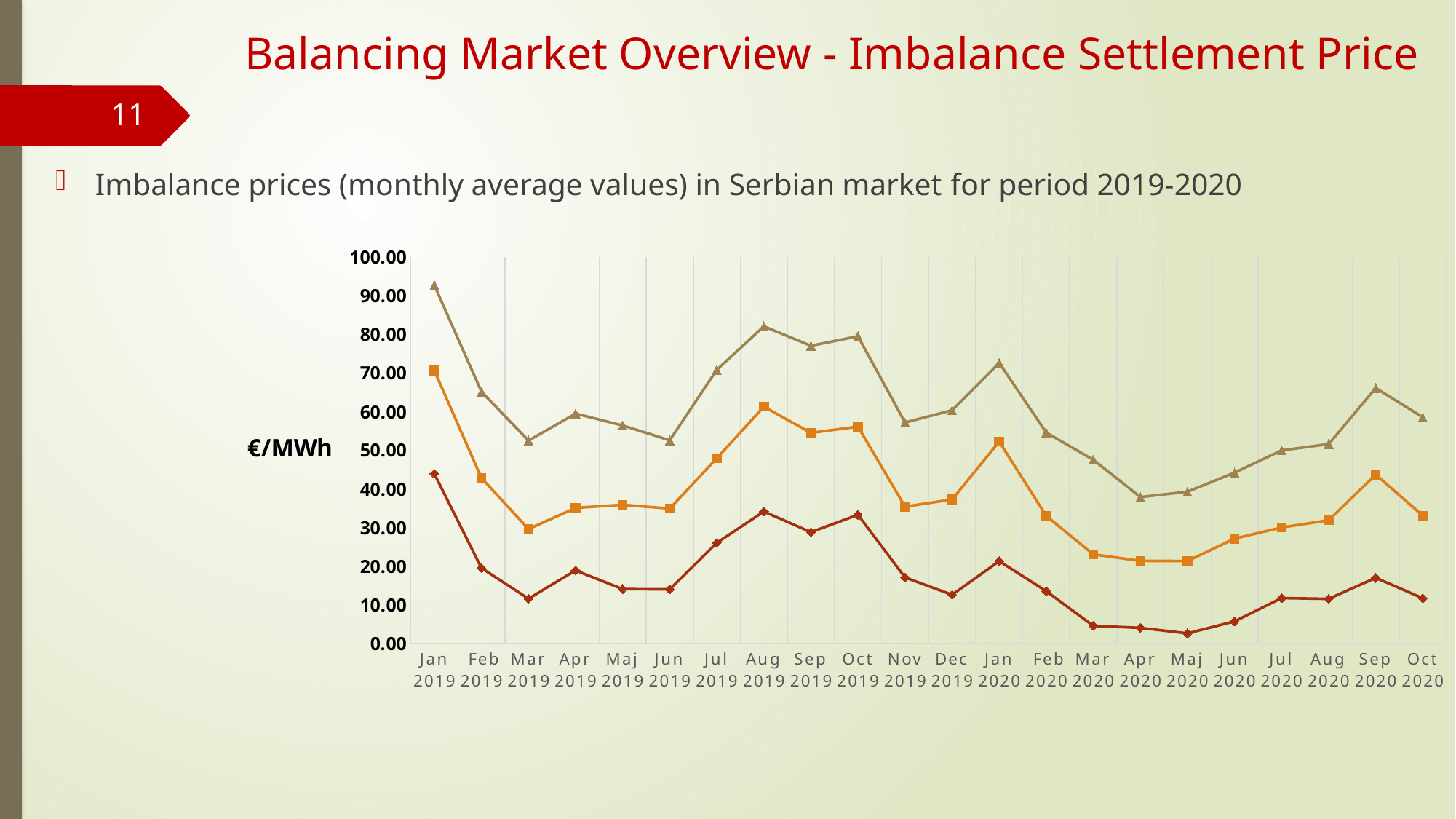
Is the value of the top (triangle-marker) line for Jan 2019 greater or less than 90.00? greater For the middle (square-marker) line, which is larger: the value for Jan 2020 or the value for Sep 2020? Jan 2020 Is the value of the top (triangle-marker) line for Nov 2019 greater or less than 60.00? less Is the value of the middle (square-marker) line for Feb 2020 greater or less than 30.00? greater In which month does the bottom (diamond-marker) line reach its lowest value? Maj 2020 In which month does the top (triangle-marker) line reach its highest value? Jan 2019 What unit label is shown on the y axis of the chart? €/MWh What kind of chart is shown on the slide? line chart How many lines are plotted on the chart? 3 What is the title of the slide containing the chart? Balancing Market Overview - Imbalance Settlement Price How many months are shown along the x axis of the chart? 22